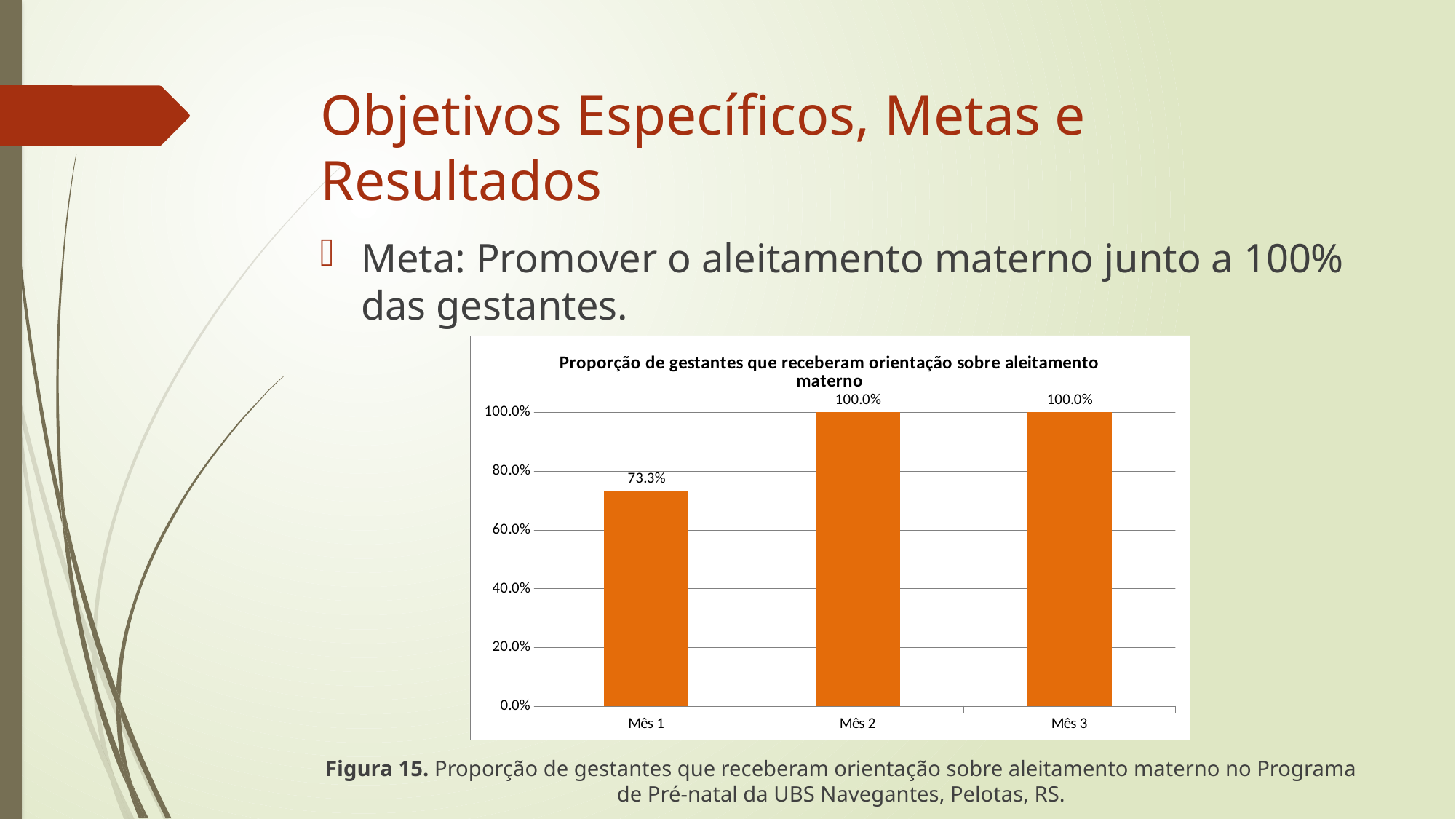
Which month has the lowest value? Mês 1 What colour are the bars in the chart? orange What is the value for Mês 3? 100.0% Which is larger, the value for Mês 1 or the value for Mês 3? Mês 3 What is the value for Mês 1? 73.3% What kind of chart is shown on the slide? bar chart How many categories are shown on the x axis? 3 Is the value for Mês 1 greater or less than 80.0%? less Do the values rise or fall from Mês 1 to Mês 2? rise What is the value for Mês 2? 100.0% What is the title of the chart? Proporção de gestantes que receberam orientação sobre aleitamento materno What is the difference between the values for Mês 2 and Mês 1? 26.7%